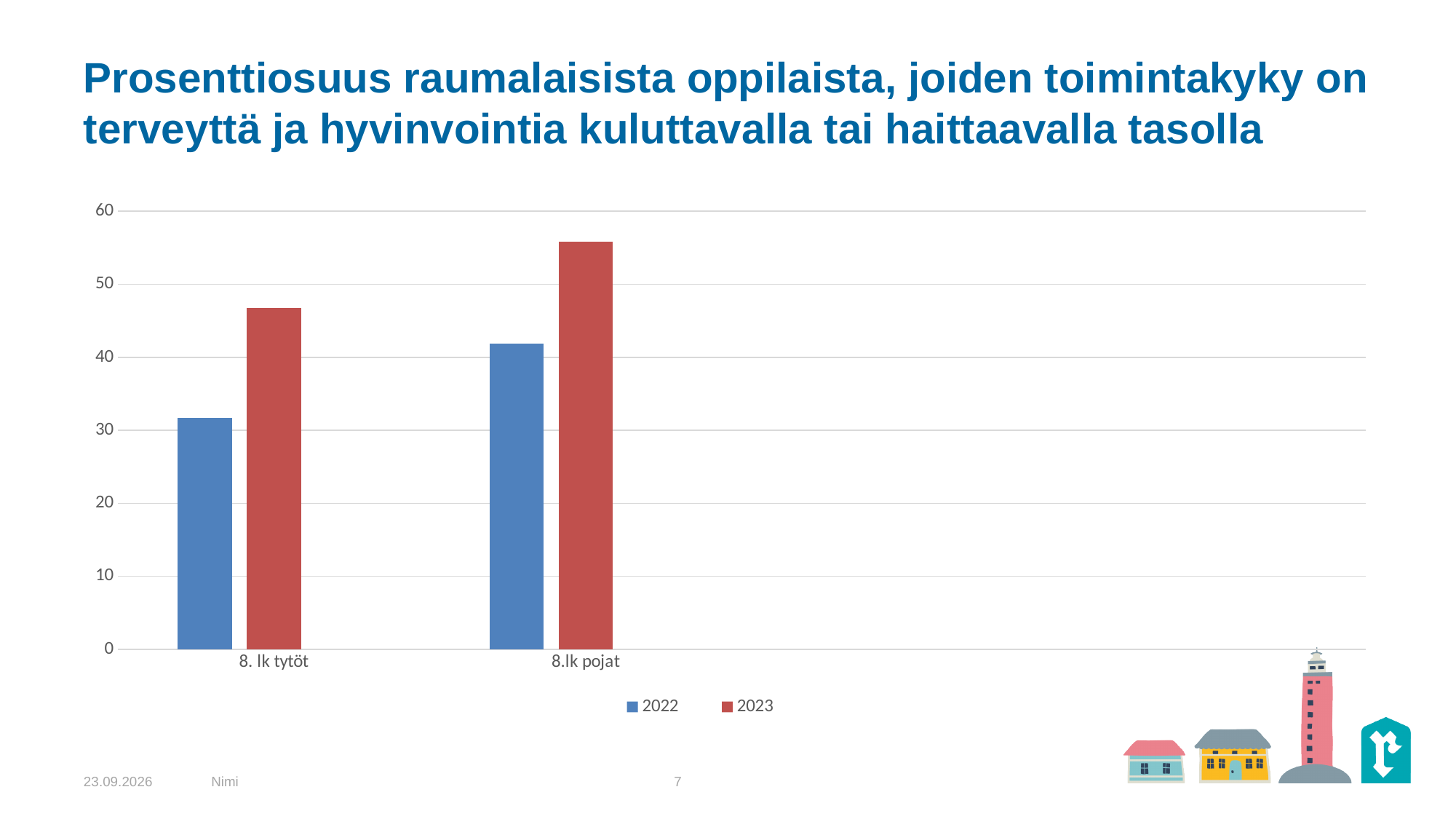
Is the 2022 value for 8. lk tytöt greater or less than 40? less Which bar is the lowest in the chart? 8. lk tytöt, 2022 Which category has the highest bar in the chart? 8.lk pojat Is the 2023 value for 8. lk tytöt greater or less than 40? greater How many categories are shown on the x axis? 2 What kind of chart is shown on the slide? bar chart Which series does the legend list first? 2022 Is the 2022 value for 8.lk pojat greater or less than 50? less Which is larger: the 2022 value for 8.lk pojat or the 2023 value for 8. lk tytöt? 2023 value for 8. lk tytöt How many series does the legend list? 2 For 8. lk tytöt, which year has the larger value, 2022 or 2023? 2023